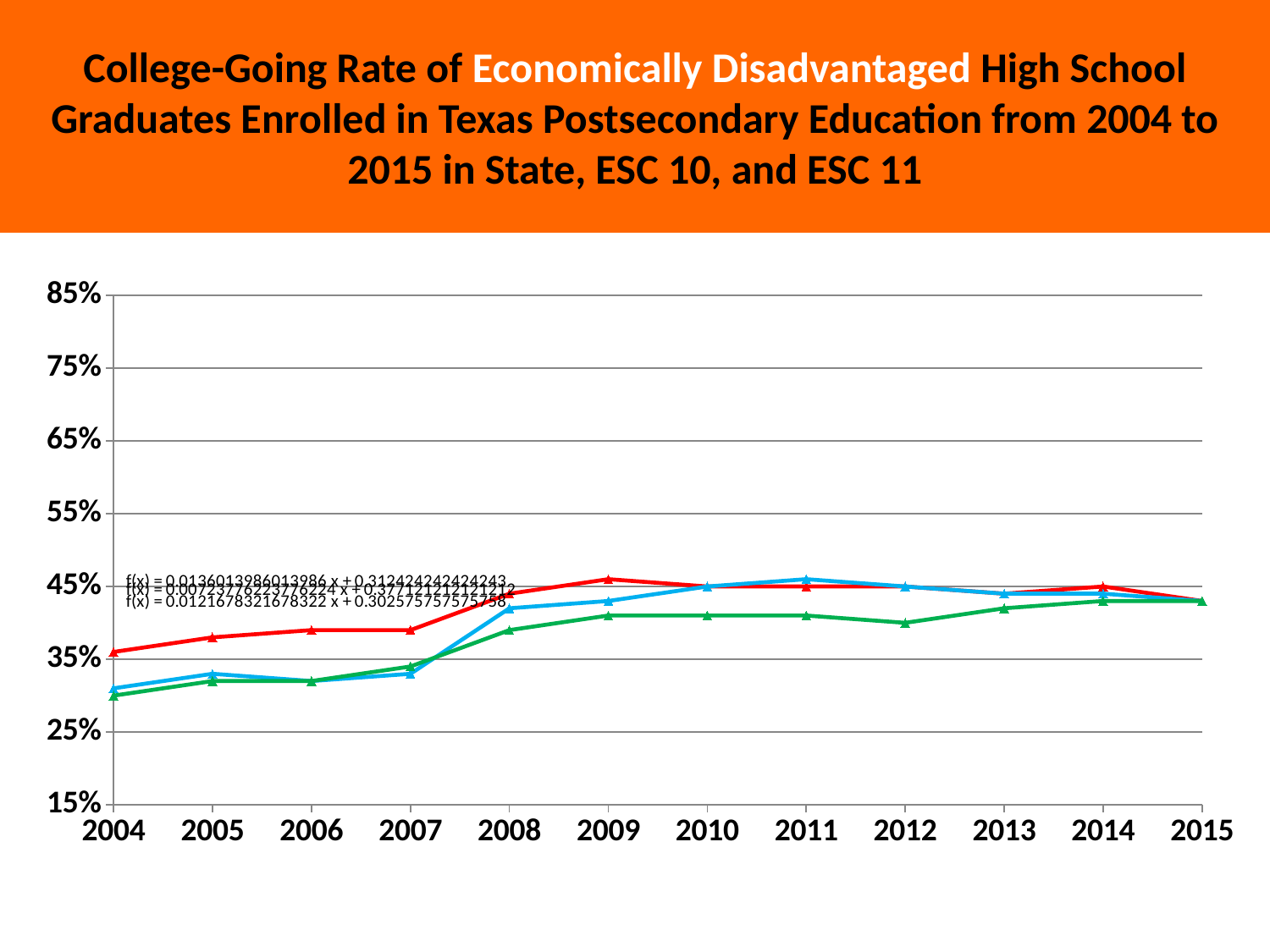
Is the value of the green line in 2004 greater or less than 35%? less How many years are plotted along the x axis of the chart? 12 Is the value of the red line in 2006 greater or less than 35%? greater What is the first year shown on the x axis of the chart? 2004 Is the value of the blue line in 2007 greater or less than 35%? less In 2012, which line is lower, the blue line or the green line? green line What kind of chart is shown on the slide? line chart In 2004, which line is higher, the red line or the green line? red line Which line has the highest value in 2004? red line How many lines are plotted on the chart? 3 Overall, do the lines rise or fall from 2004 to 2015? rise